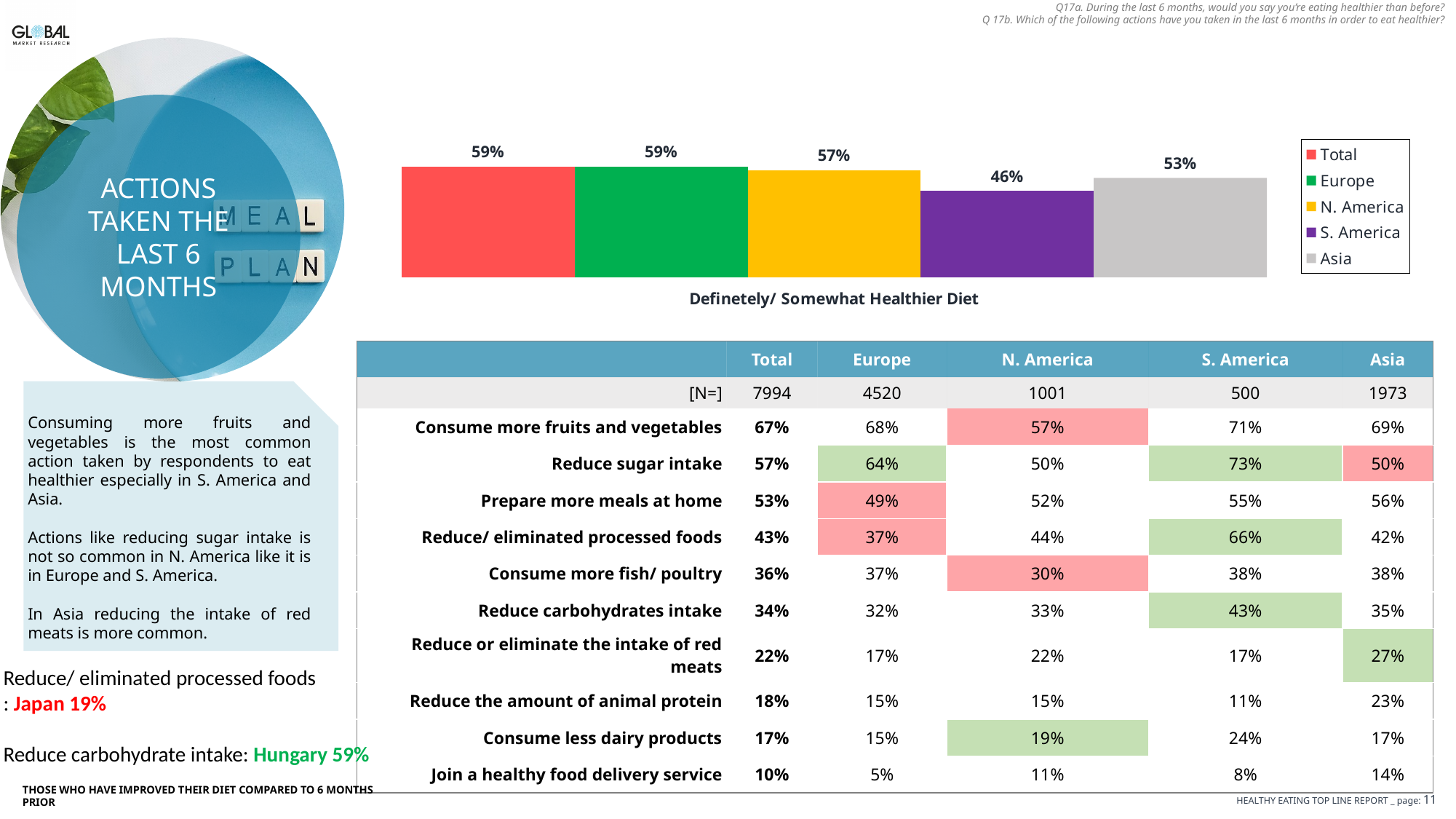
What is the difference between the values for Europe and Asia in the bar chart? 6% What kind of chart is shown above the table? bar chart How many bars are shown in the bar chart? 5 What is the category label shown beneath the bars of the bar chart? Definetely/ Somewhat Healthier Diet How many series does the legend of the bar chart list? 5 What is the difference between the values for N. America and S. America in the bar chart? 11% What is the value for S. America in the bar chart? 46% What is the value for Europe in the bar chart? 59% What is the value for Asia in the bar chart? 53% What is the value for N. America in the bar chart? 57% In the bar chart, which is larger, the value for Asia or the value for S. America? Asia Which region has the lowest value in the bar chart? S. America